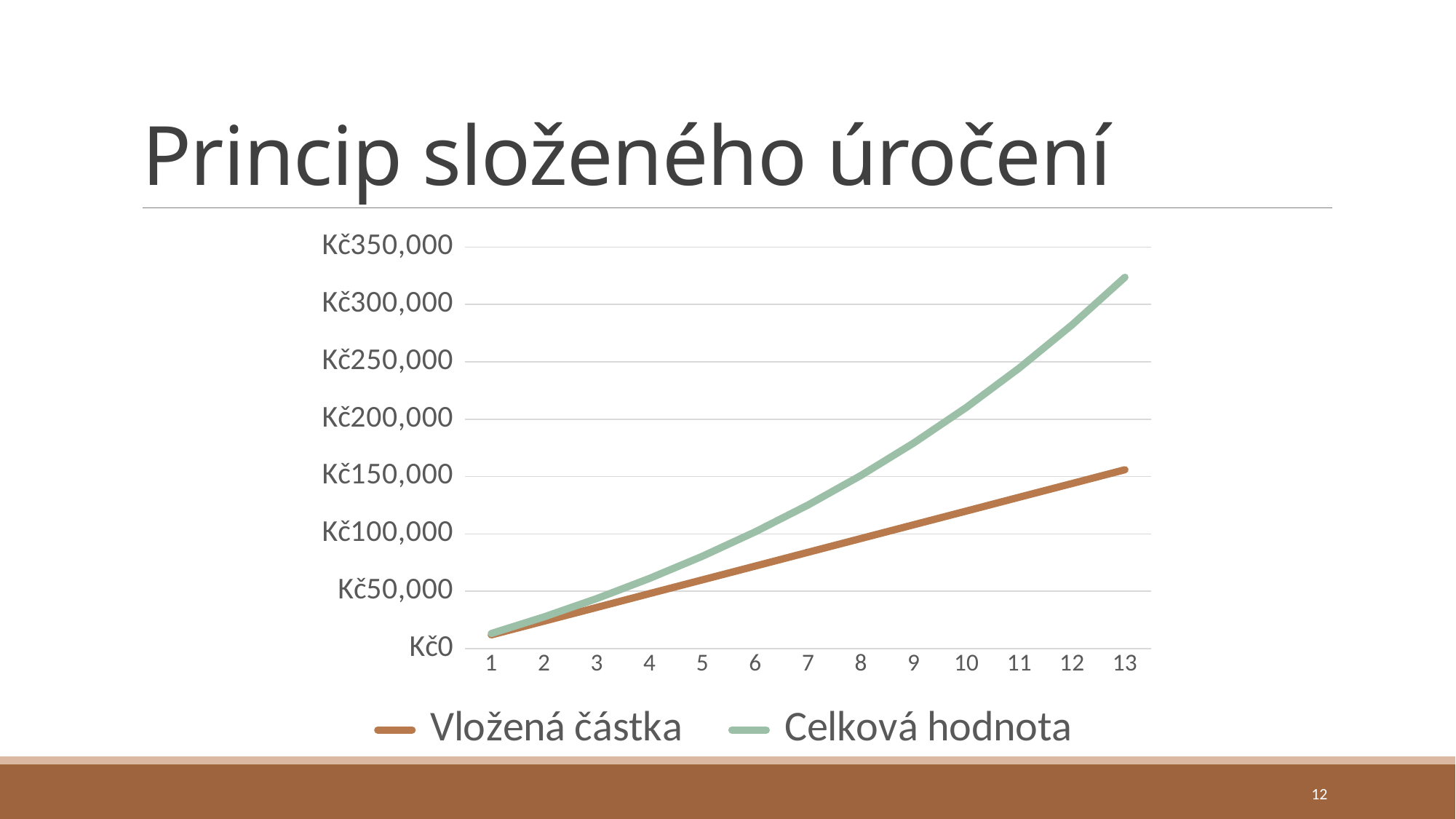
What is the title of the slide containing the chart? Princip složeného úročení Is the value of Vložená částka at point 13 greater or less than Kč200,000? less Which two series are listed in the legend? Vložená částka and Celková hodnota Is the value of Celková hodnota at point 7 greater or less than Kč100,000? greater How many points are plotted along the x axis for each series? 13 Is the value of Celková hodnota at point 13 greater or less than Kč300,000? greater How many series does the legend list? 2 At which x-axis point does Celková hodnota reach its highest value? 13 Do the values of Celková hodnota rise or fall from 1 to 13? rise At point 13, which series has the larger value, Vložená částka or Celková hodnota? Celková hodnota Do the values of Vložená částka rise or fall along the x axis? rise What kind of chart is shown on the slide? line chart